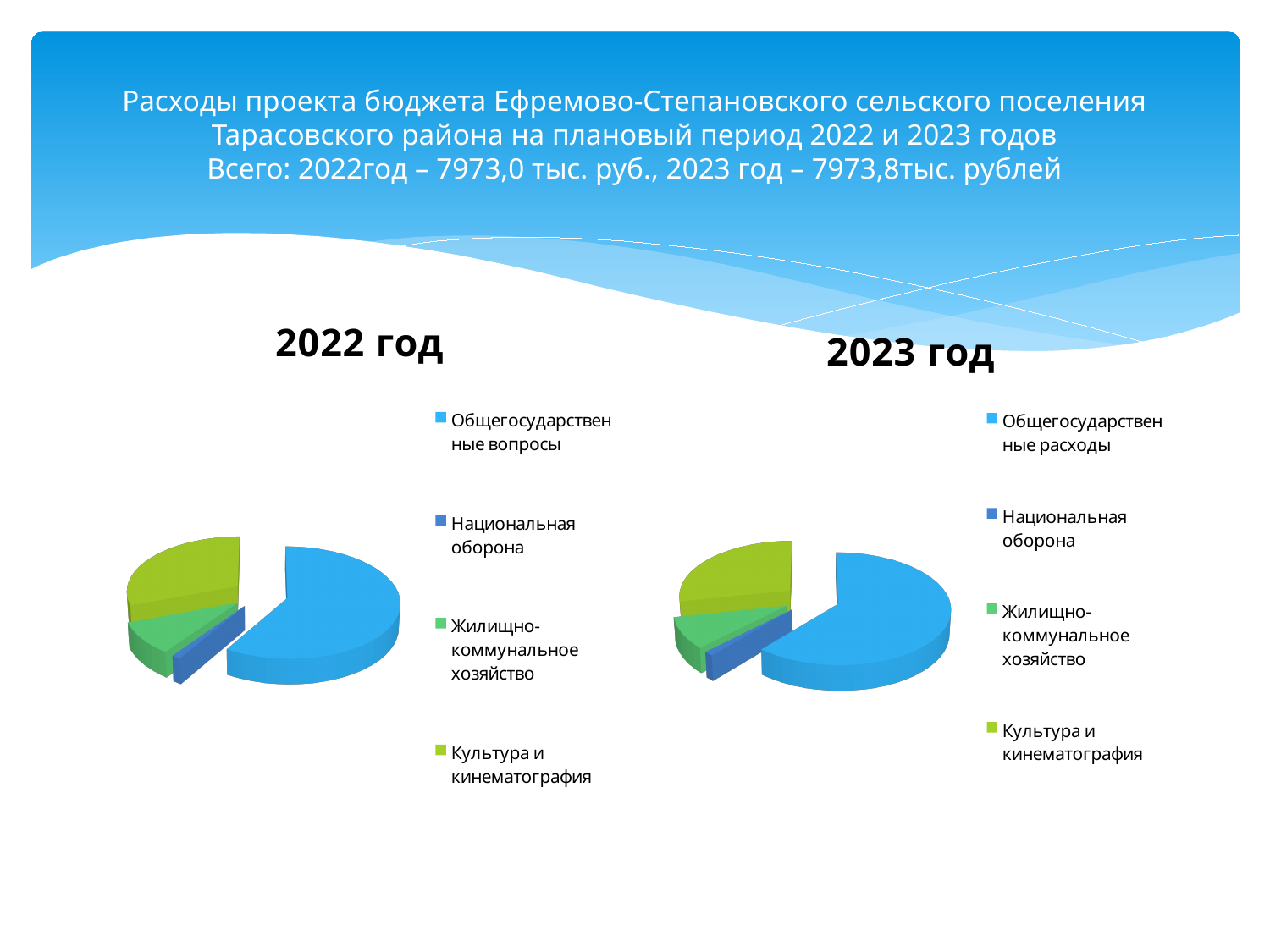
In the "2022 год" chart, which slice is larger: Культура и кинематография or Жилищно-коммунальное хозяйство? Культура и кинематография What is the title of the chart on the right? 2023 год In the "2023 год" chart, which category has the smallest slice? Национальная оборона In the "2022 год" chart, which category has the smallest slice? Национальная оборона What kind of chart is the "2022 год" chart on the left? pie chart In the "2023 год" chart, which category has the largest slice? Общегосударственные расходы What kind of chart is the "2023 год" chart on the right? pie chart In the "2023 год" chart, how many categories does the legend list? 4 In the "2022 год" chart, which category has the largest slice? Общегосударственные вопросы In the "2023 год" chart, which slice is larger: Общегосударственные расходы or Культура и кинематография? Общегосударственные расходы In the "2022 год" chart, how many slices does the pie have? 4 In the "2022 год" chart, what colour is the slice for Национальная оборона? dark blue